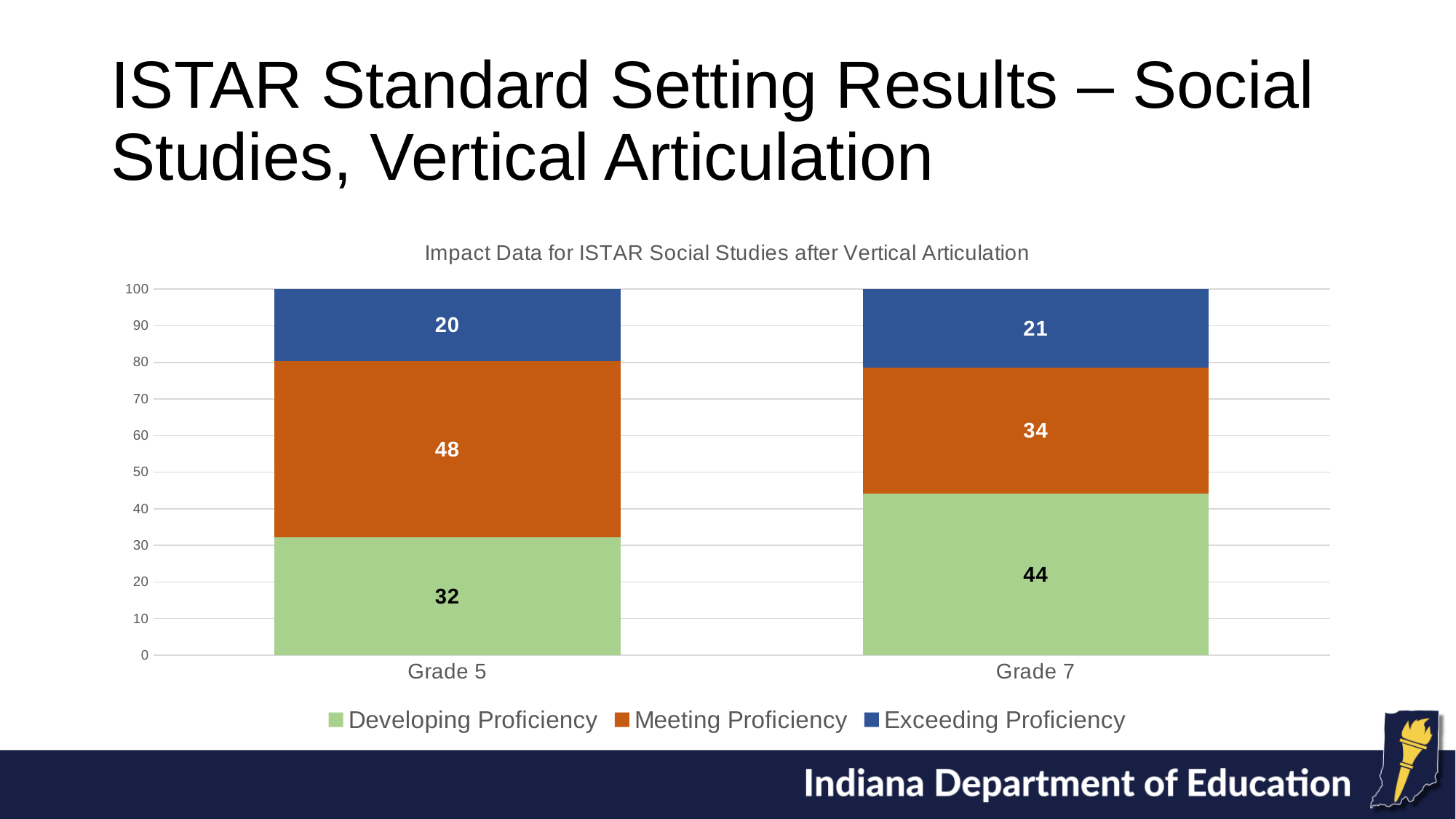
Which proficiency level has the largest value for Grade 5? Meeting Proficiency What is the difference between the Developing Proficiency values for Grade 7 and Grade 5? 12 What is the Developing Proficiency value for Grade 7? 44 What is the difference between the Meeting Proficiency values for Grade 5 and Grade 7? 14 Which grade has the higher Meeting Proficiency value? Grade 5 What is the Developing Proficiency value for Grade 5? 32 What is the Meeting Proficiency value for Grade 7? 34 What is the Exceeding Proficiency value for Grade 5? 20 Which proficiency level has the smallest value for Grade 7? Exceeding Proficiency How many series does the legend list? 3 What type of chart is shown on the slide? Stacked bar chart What is the total of the stacked bar for Grade 5? 100